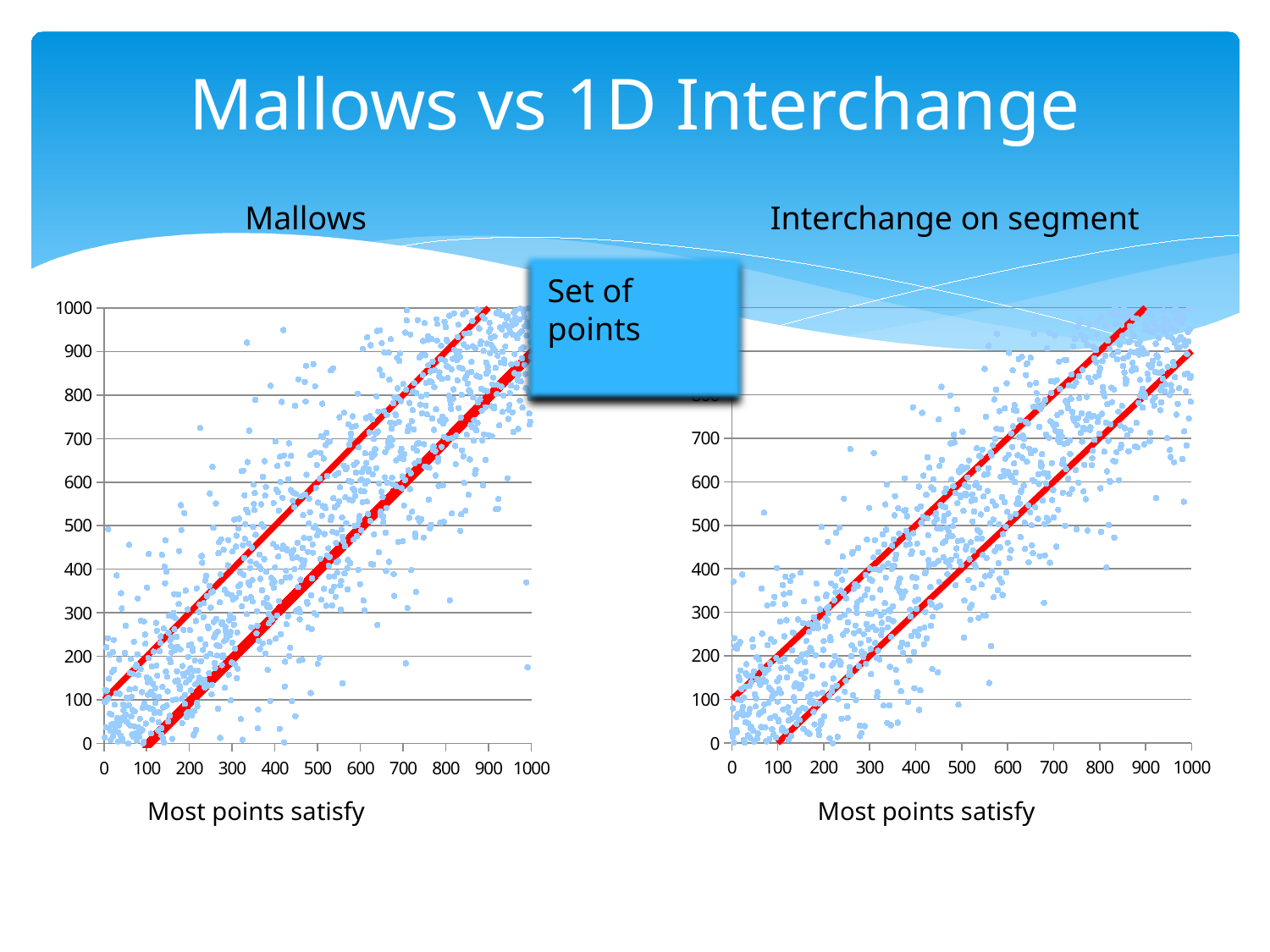
What is the highest tick value shown on the x axis of the "Interchange on segment" chart? 1000 What is the title of the chart on the left side of the slide? Mallows What kind of chart is the right chart titled "Interchange on segment"? scatter chart What is the highest tick value shown on the y axis of the "Mallows" chart? 1000 In the "Mallows" chart, do the plotted points generally rise or fall as the x value increases? rise In the "Interchange on segment" chart, do the plotted points generally rise or fall as the x value increases? rise What kind of chart is the left chart titled "Mallows"? scatter chart In the "Interchange on segment" chart, how many red diagonal lines are drawn over the points? 2 How many charts are shown on the slide? 2